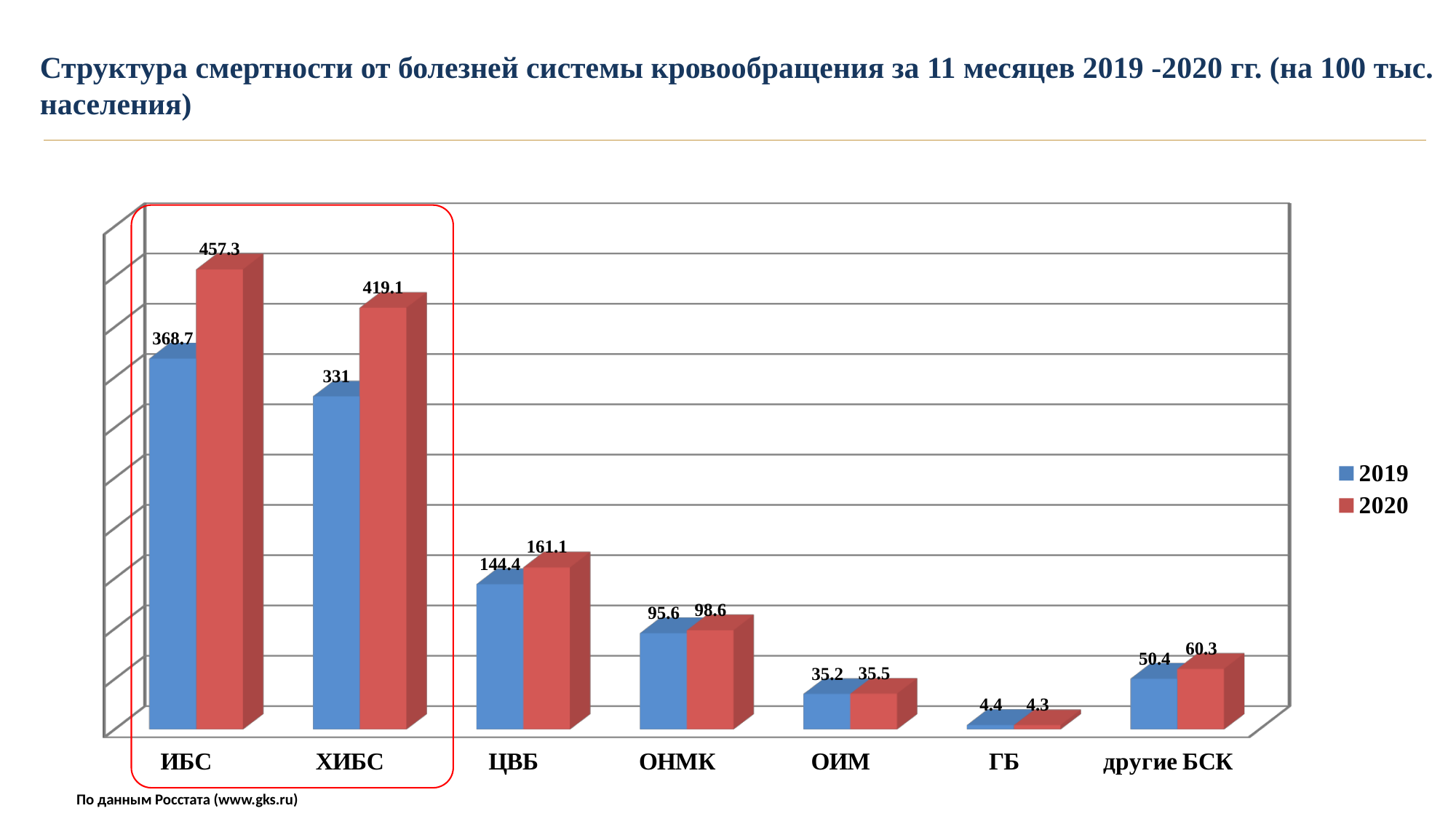
Which category has the lowest 2019 value? ГБ Which is larger for ЦВБ, the 2019 value or the 2020 value? 2020 What kind of chart is shown on the slide? Bar chart Which category has the highest 2020 value? ИБС What is the 2020 value for ЦВБ? 161.1 How many categories are shown on the x axis? 7 What is the 2019 value for другие БСК? 50.4 How many series does the legend list? 2 What is the 2019 value for ХИБС? 331 What is the 2020 value for ИБС? 457.3 What is the difference between the 2020 and 2019 values for ХИБС? 88.1 What is the difference between the 2020 and 2019 values for ИБС? 88.6